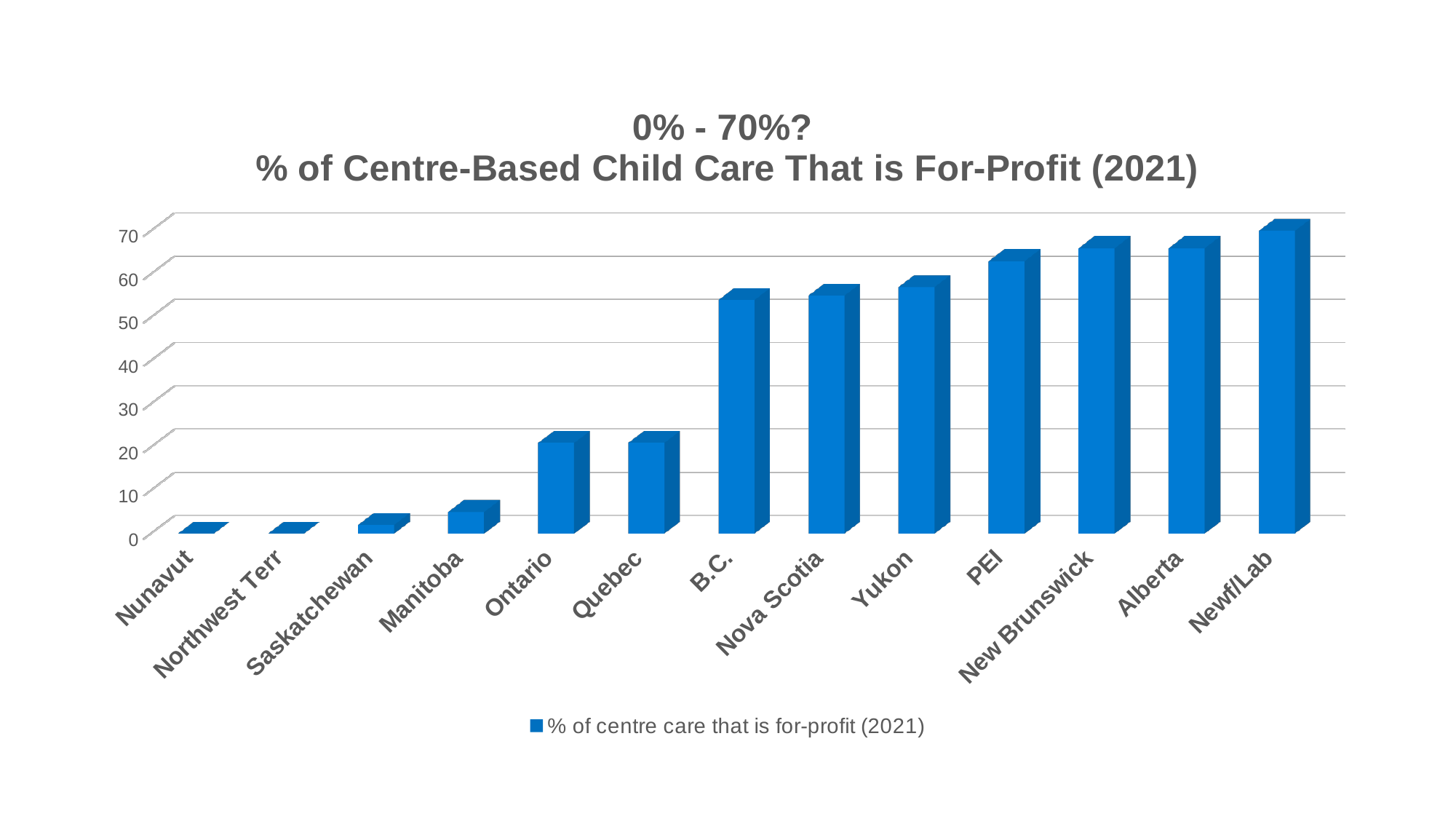
What kind of chart is shown on the slide? Bar chart Is the value for Ontario greater or less than 30? less Is the value for Nova Scotia greater or less than 40? greater Is the value for Newf/Lab greater or less than 60? greater Do the values generally rise or fall moving from left to right along the x axis? Rise Which has a higher value, Yukon or Quebec? Yukon Which province or territory has the highest percentage of centre-based child care that is for-profit? Newf/Lab How many series does the legend list? 1 How many provinces and territories are shown on the x axis of the chart? 13 Which has a higher value, Saskatchewan or PEI? PEI What is the legend entry for the series shown in the chart? % of centre care that is for-profit (2021)